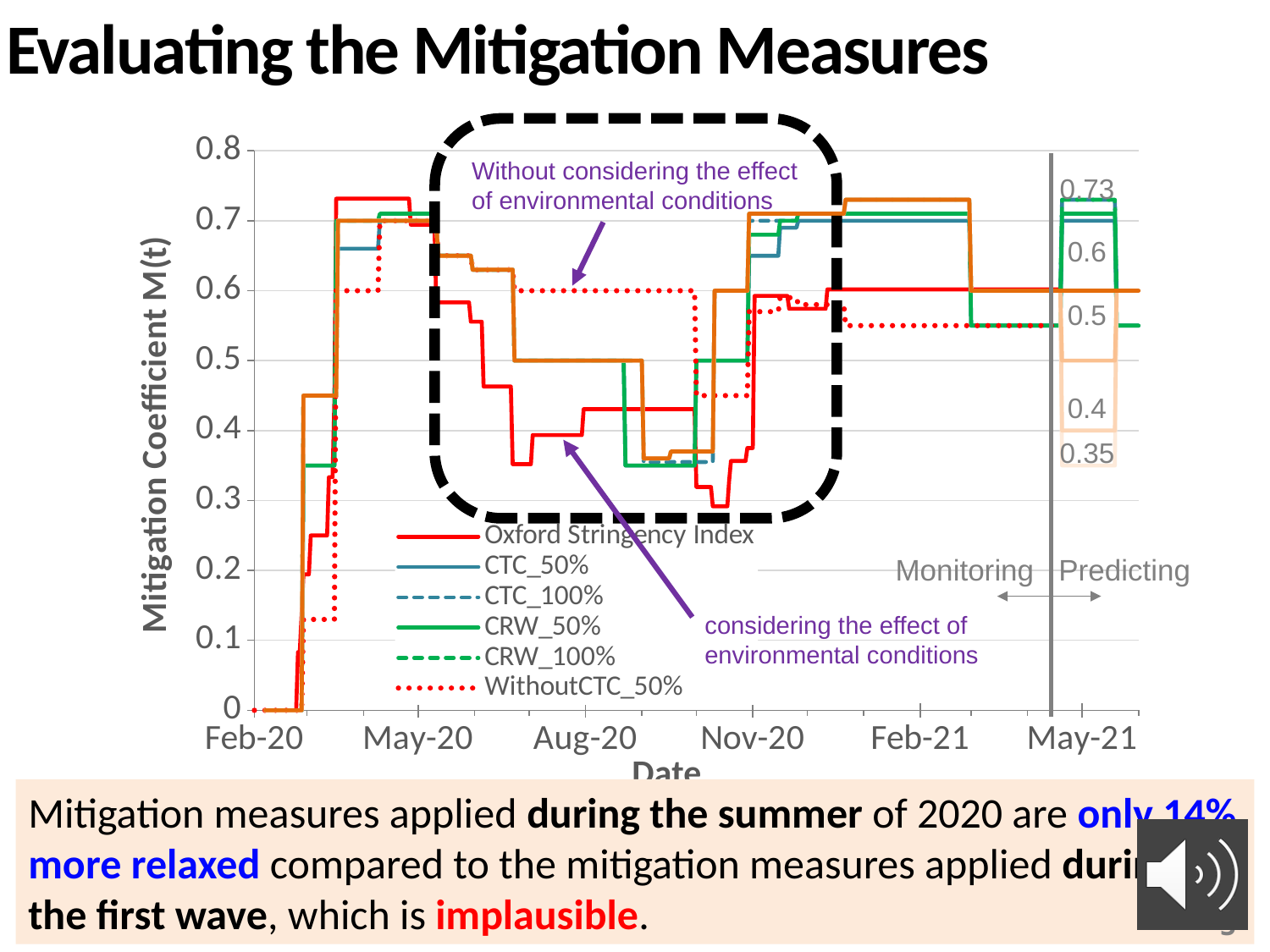
What is the title of the y axis? Mitigation Coefficient M(t) Which series is drawn as a red dotted line? WithoutCTC_50% How many series does the legend list? 6 Is the value of CTC_50% at Feb-21 greater or less than 0.6? greater Is the value of the Oxford Stringency Index at Aug-20 greater or less than 0.5? less What kind of chart is shown on the slide? line chart Is the value of the Oxford Stringency Index at Feb-21 greater or less than 0.5? greater How many date labels are shown on the x axis? 6 At Aug-20, which is larger: WithoutCTC_50% or the Oxford Stringency Index? WithoutCTC_50% Does the Oxford Stringency Index rise or fall between Feb-20 and May-20? rise